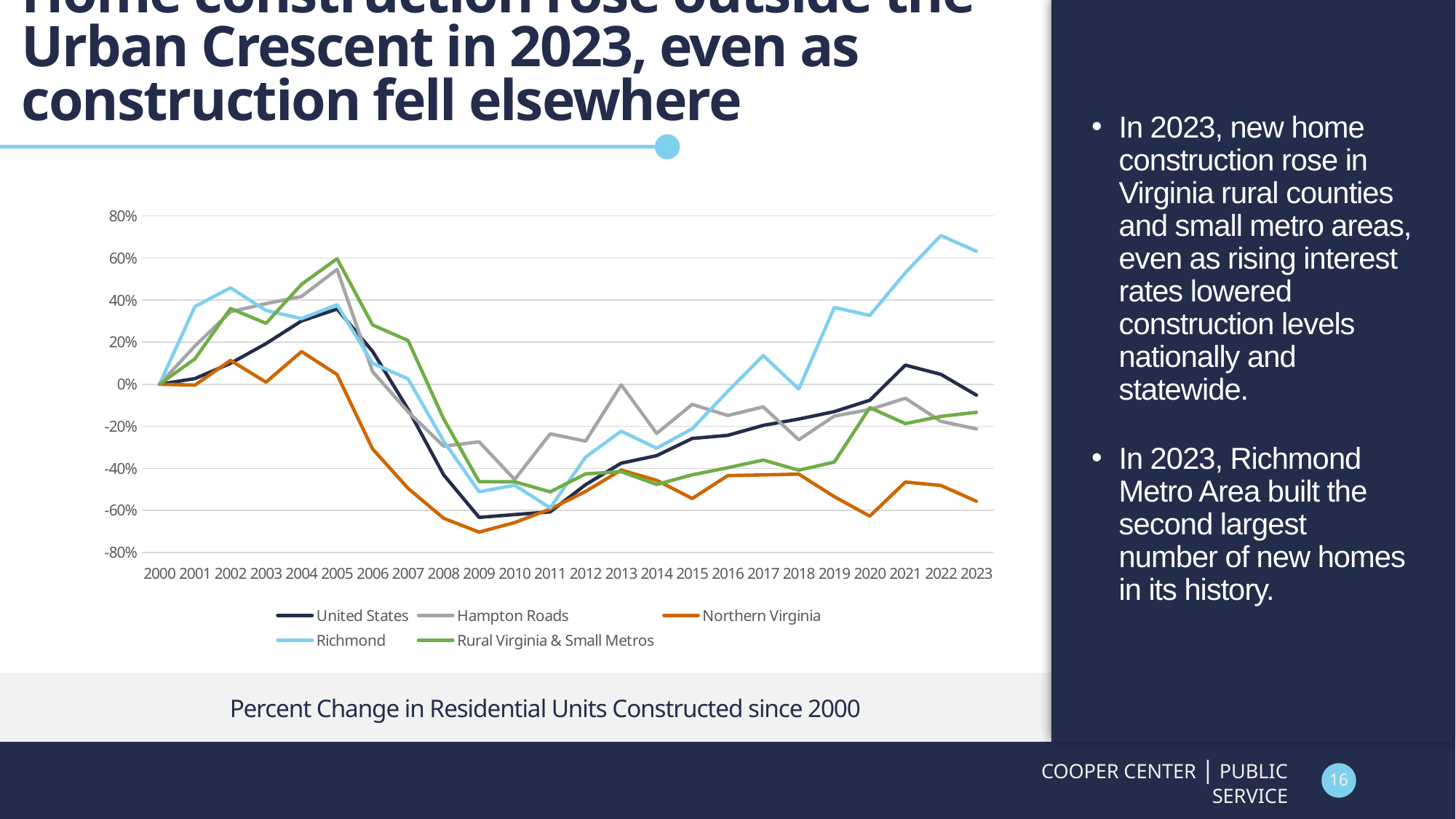
Which series has the lowest value in 2023? Northern Virginia How many years are shown along the x axis of the chart? 24 Is the value for Richmond in 2022 greater or less than 60%? greater Is the value for Hampton Roads in 2023 greater or less than 0%? less What kind of chart is shown on the slide? line chart In 2023, which is larger: the value for United States or the value for Hampton Roads? United States Is the value for Northern Virginia in 2009 greater or less than -60%? less What is the caption below the chart? Percent Change in Residential Units Constructed since 2000 What is the value for United States in 2000? 0% How many series does the chart legend list? 5 Does the Richmond line rise or fall from 2018 to 2022? rise Which series has the highest value in 2023? Richmond